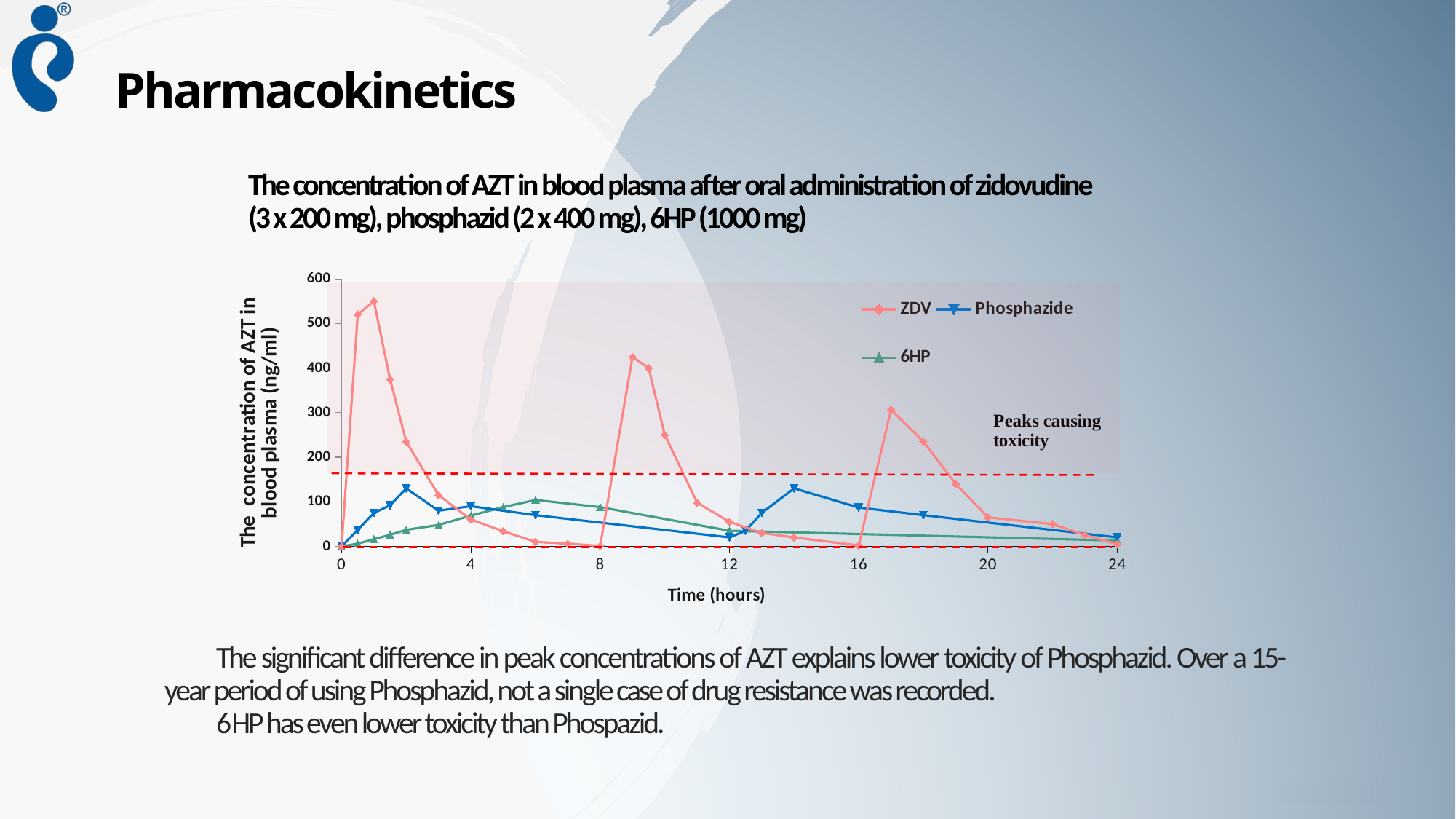
Is the highest value for 6HP greater or less than 200? less Is the highest value for Phosphazide greater or less than 200? less What does the annotation in the shaded area of the chart say? Peaks causing toxicity Does the ZDV concentration rise or fall between 1 hour and 8 hours? Fall Which series reaches the highest concentration of AZT in blood plasma? ZDV What kind of chart is shown on the slide? Line chart How many series does the chart legend list? 3 What is the label of the x axis? Time (hours) Which series has the higher peak concentration, Phosphazide or 6HP? Phosphazide Is the peak value for ZDV at around 1 hour greater or less than 500? greater